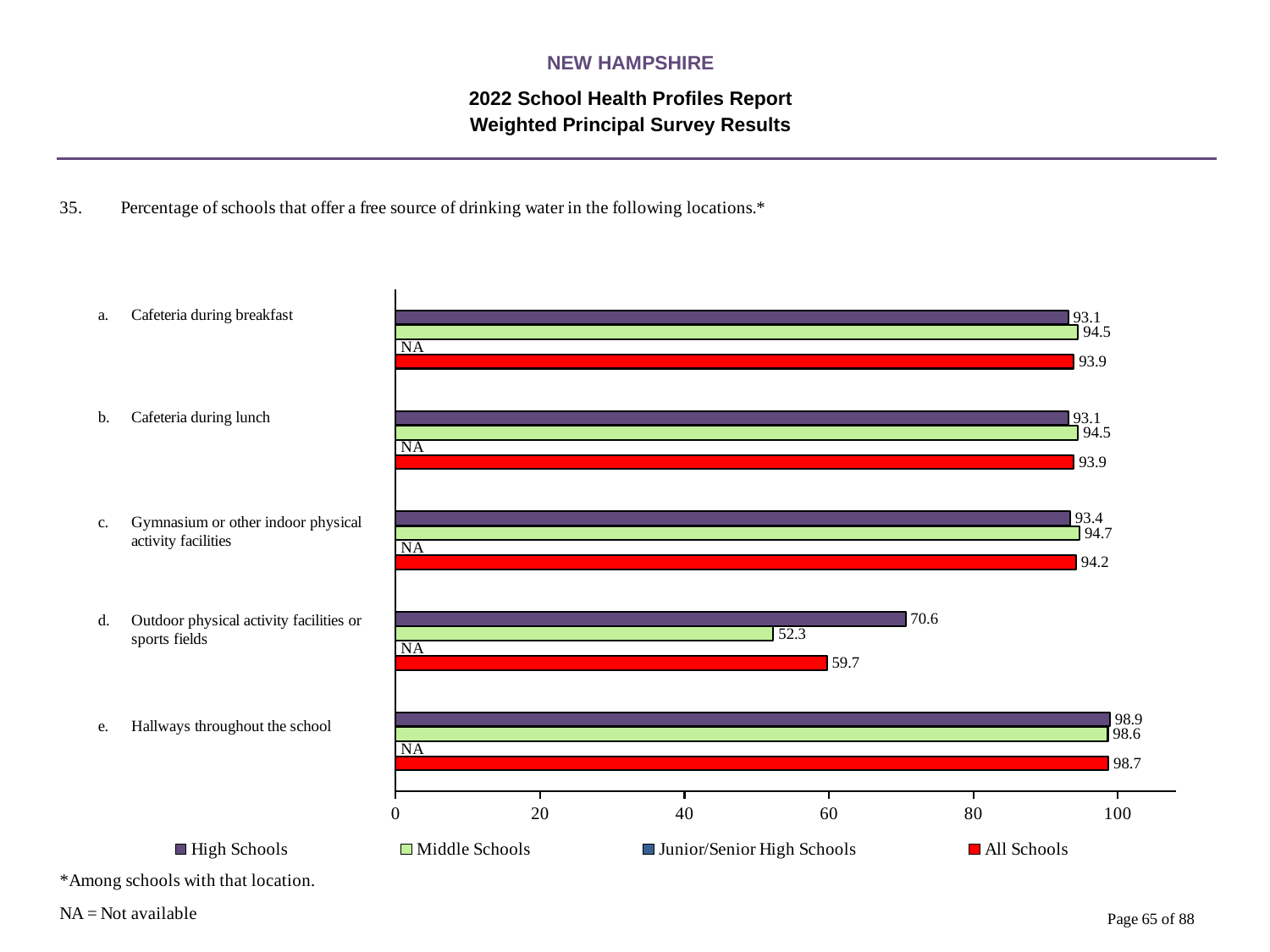
How many locations (categories) are shown in the chart? 5 Which location has the highest value for High Schools? Hallways throughout the school What kind of chart is shown on the slide? bar chart What is the difference between the High Schools and Middle Schools values for 'Outdoor physical activity facilities or sports fields'? 18.3 What is the value for Junior/Senior High Schools for 'Cafeteria during lunch'? NA Which location has the lowest value for All Schools? Outdoor physical activity facilities or sports fields What is the value for All Schools for 'Gymnasium or other indoor physical activity facilities'? 94.2 What is the value for Middle Schools for 'Hallways throughout the school'? 98.6 For 'Cafeteria during breakfast', which is larger: the High Schools value or the Middle Schools value? Middle Schools How many series does the legend list? 4 Is the Middle Schools value for 'Outdoor physical activity facilities or sports fields' greater or less than 60? less What is the value for High Schools for 'Outdoor physical activity facilities or sports fields'? 70.6